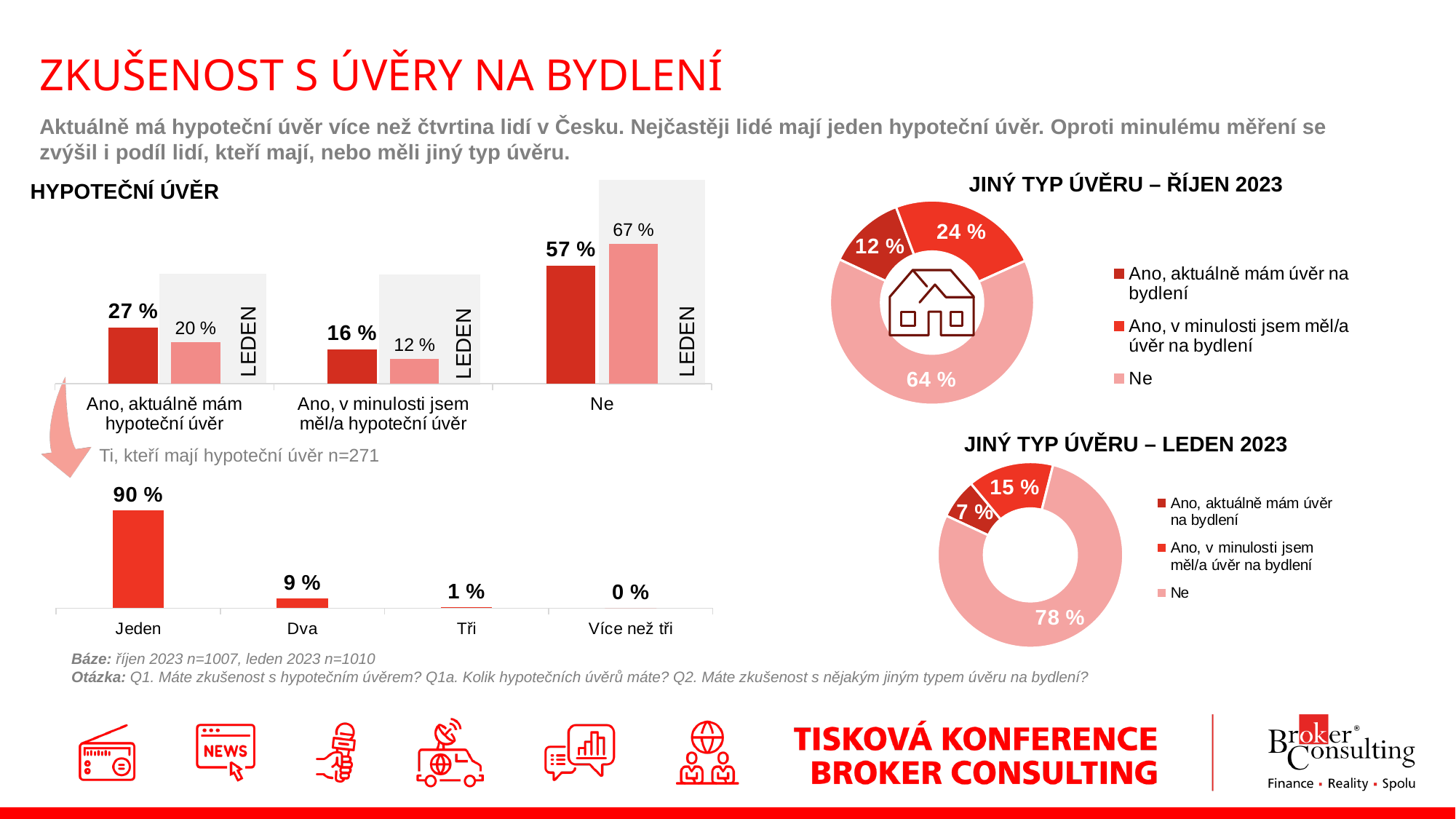
In the 'HYPOTEČNÍ ÚVĚR' bar chart, what was the LEDEN value for 'Ne'? 67 % What type of chart is 'JINÝ TYP ÚVĚRU – ŘÍJEN 2023'? Donut (pie) chart In the 'HYPOTEČNÍ ÚVĚR' bar chart, what is the difference between the current and LEDEN values for 'Ano, v minulosti jsem měl/a hypoteční úvěr'? 4 % In the 'HYPOTEČNÍ ÚVĚR' bar chart, which category has the highest current value? Ne In the lower bar chart (Ti, kteří mají hypoteční úvěr n=271), how many categories are shown? 4 In the lower bar chart (Ti, kteří mají hypoteční úvěr n=271), what is the value for 'Jeden'? 90 % In the lower bar chart (Ti, kteří mají hypoteční úvěr n=271), which category has the lowest value? Více než tři How many entries does the legend of the 'JINÝ TYP ÚVĚRU – LEDEN 2023' chart list? 3 In the 'JINÝ TYP ÚVĚRU – LEDEN 2023' chart, what is the value for 'Ne'? 78 % Which is larger: the 'Ano, aktuálně mám úvěr na bydlení' share in the ŘÍJEN 2023 chart or in the LEDEN 2023 chart? ŘÍJEN 2023 (12 %) In the 'JINÝ TYP ÚVĚRU – ŘÍJEN 2023' chart, what is the share for 'Ano, v minulosti jsem měl/a úvěr na bydlení'? 24 % In the 'HYPOTEČNÍ ÚVĚR' bar chart, what is the current value for 'Ano, aktuálně mám hypoteční úvěr'? 27 %